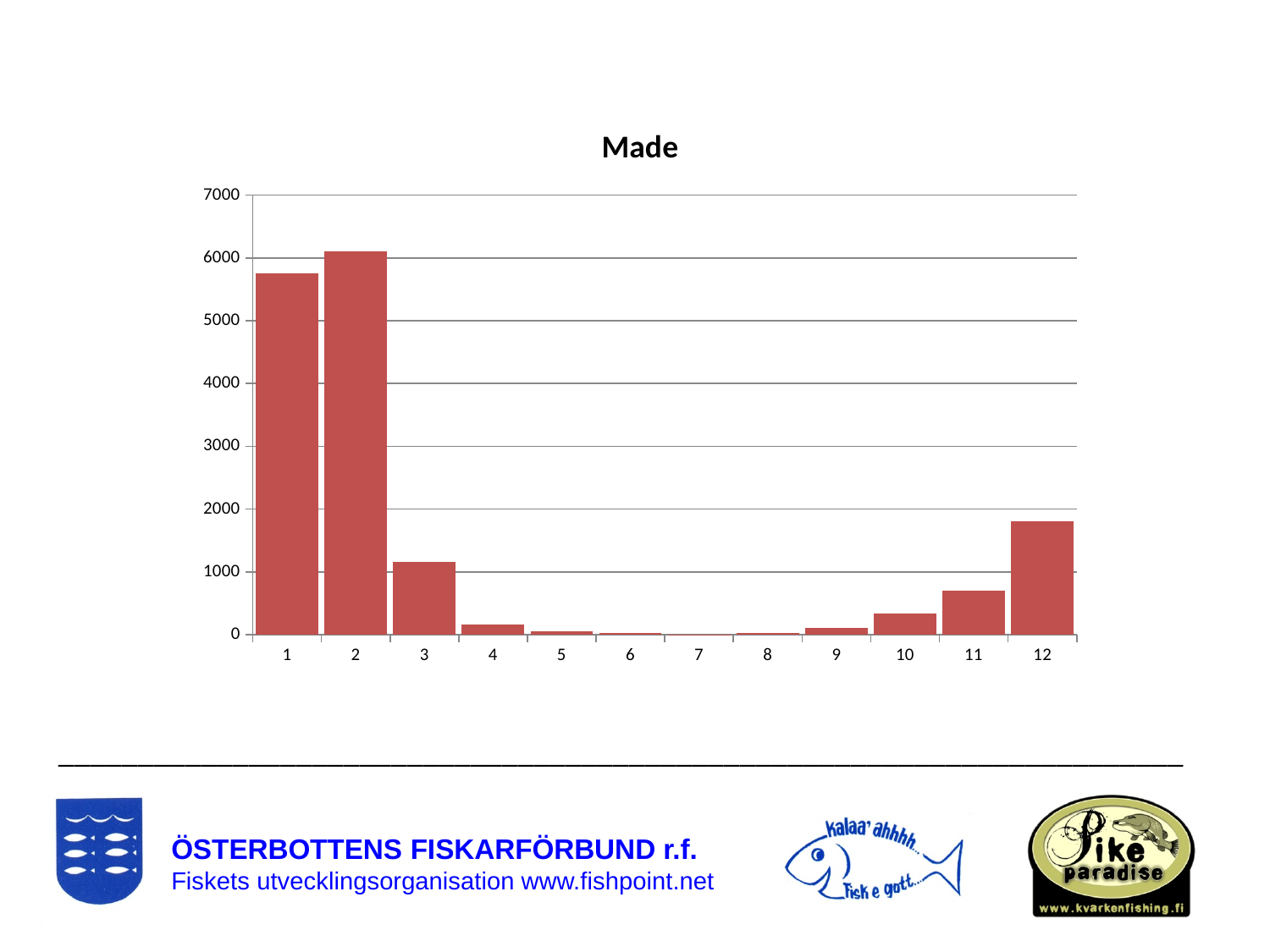
Is the value for category 1 greater or less than 5000? greater Which is larger, the value for category 10 or the value for category 11? 11 Which category has the highest value in the chart? 2 What is the title of the chart? Made How many categories are shown on the x axis of the chart? 12 Do the values rise or fall from category 9 to category 12? rise Is the value for category 3 greater or less than 1000? greater Which is larger, the value for category 3 or the value for category 12? 12 Is the value for category 12 greater or less than 2000? less What kind of chart is shown on the slide? bar chart